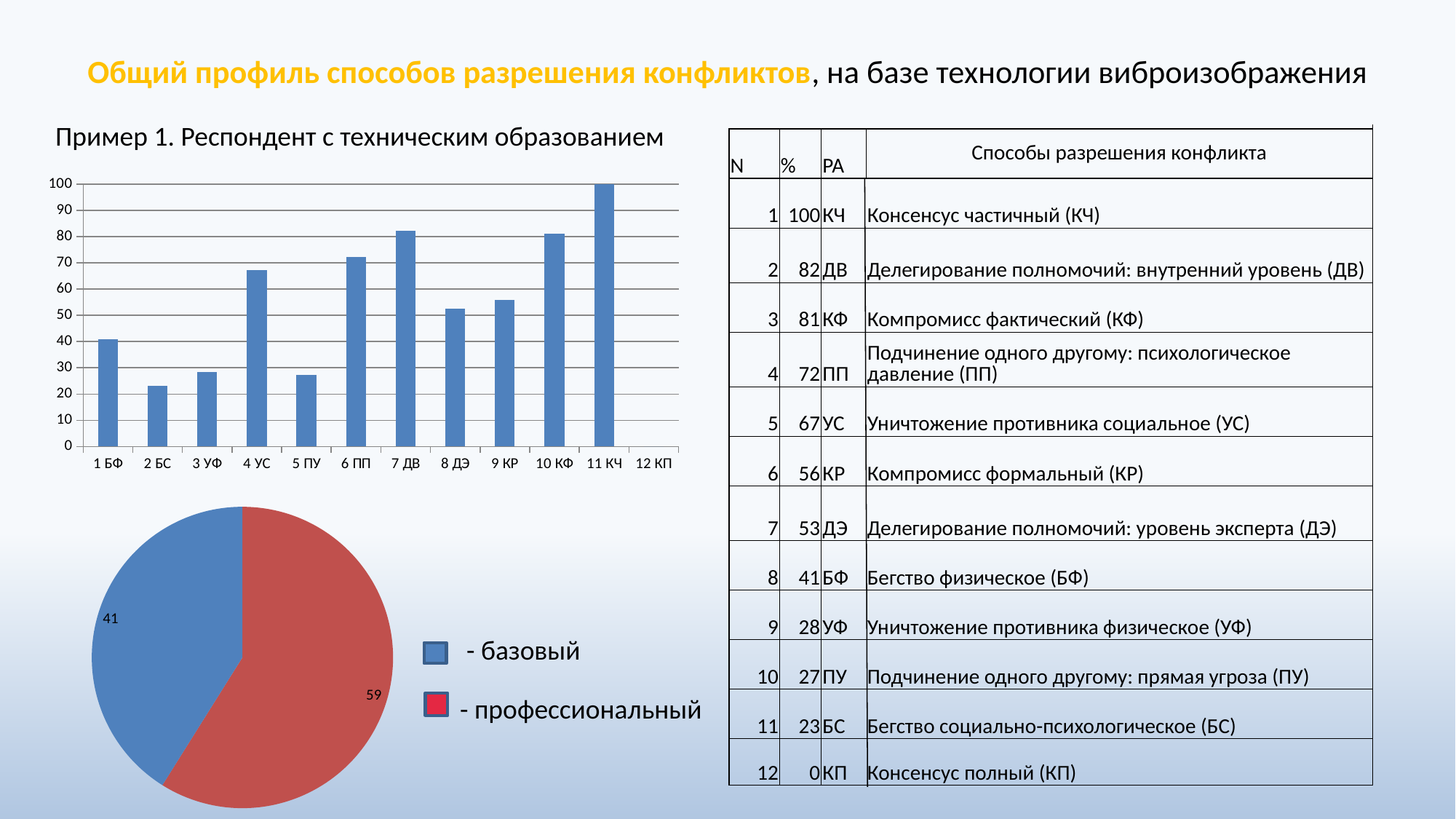
In the bar chart, is the value for 4 УС greater or less than 60? greater What kind of chart is the top-left chart on the slide? bar chart In the bar chart, which is larger, the value for 6 ПП or the value for 9 КР? 6 ПП In the bar chart, is the value for 2 БС greater or less than 30? less In the pie chart, what is the value of the blue slice (базовый)? 41 In the bar chart, which category has the highest bar? 11 КЧ What kind of chart is the bottom-left chart on the slide? pie chart In the bar chart, what is the value for 11 КЧ? 100 In the pie chart, what is the value of the red slice (профессиональный)? 59 In the bar chart, is the value for 7 ДВ greater or less than 80? greater In the pie chart, what is the difference between the профессиональный slice and the базовый slice? 18 In the bar chart, how many categories are shown on the x axis? 12